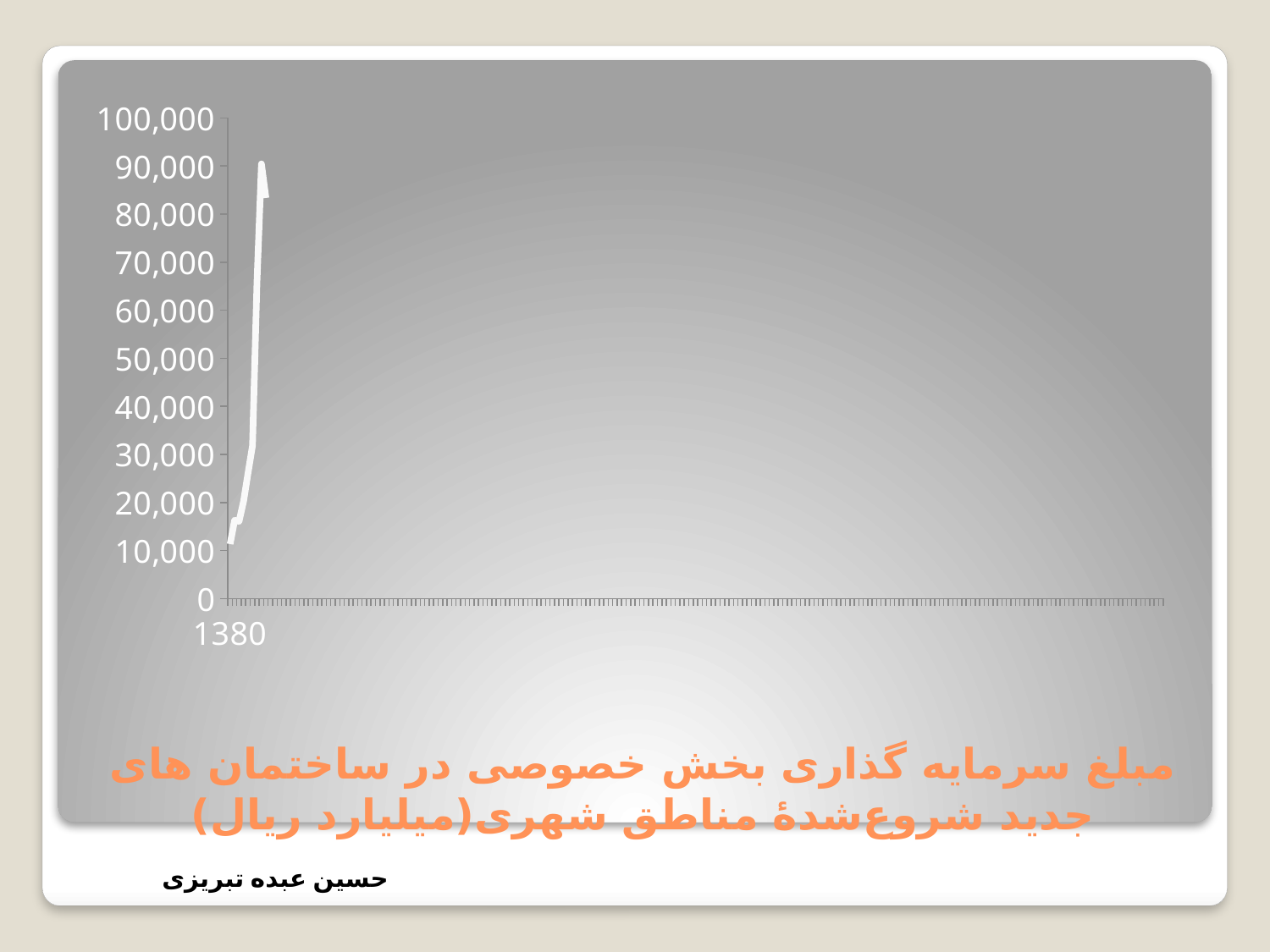
How many lines are plotted on the chart? 1 What is the only year label shown on the x axis? 1380 What kind of chart is shown on the slide? line chart What is the highest value shown on the y axis? 100,000 Is the starting value of the line greater or less than 20,000? less Is the highest point of the line greater or less than 80,000? greater Is the highest point of the line greater or less than 100,000? less Does the plotted line rise or fall as it moves along the x axis? rises